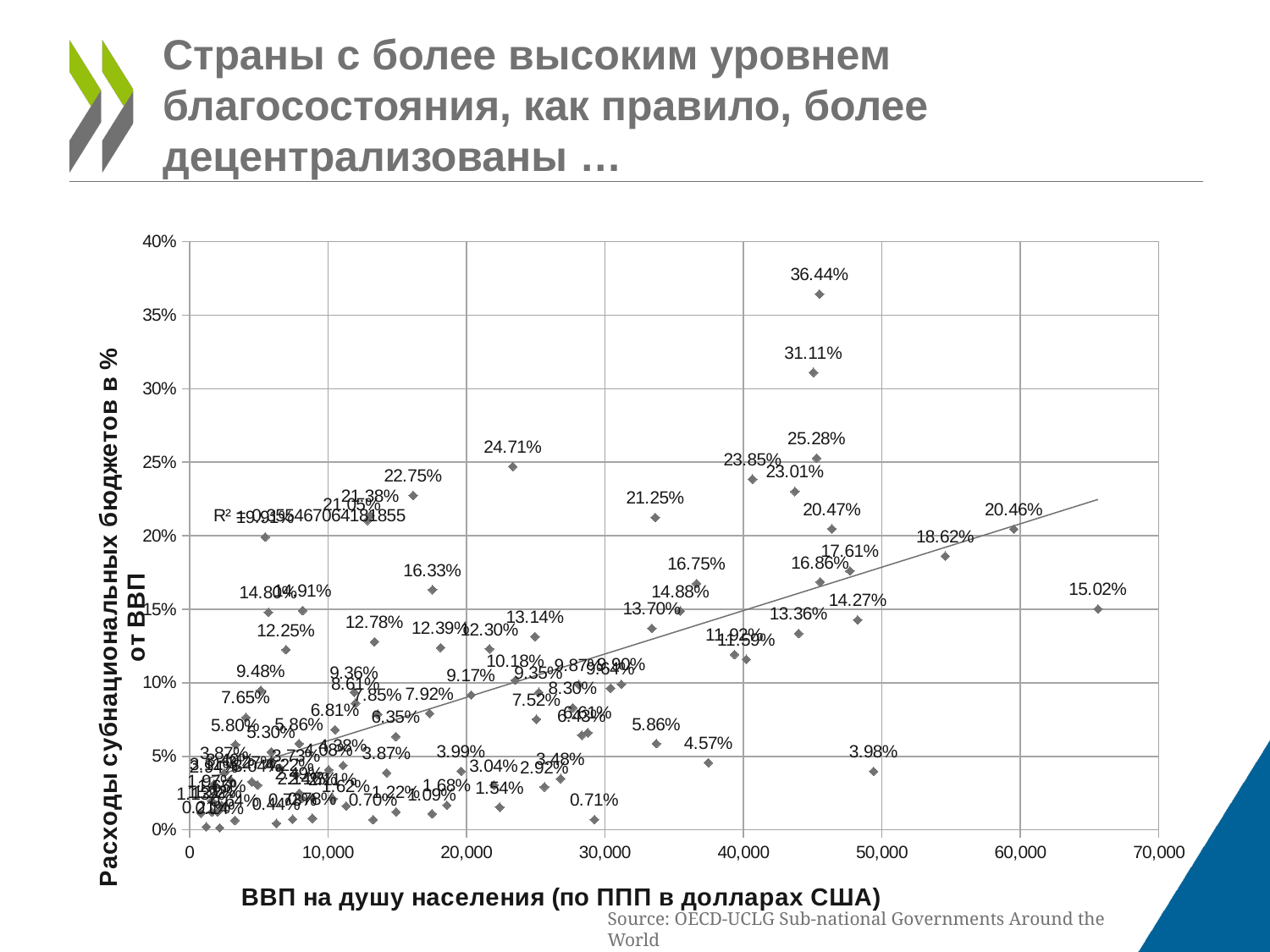
What is the second-highest data label value shown on the chart? 31.11% Which is larger: the point labelled 24.71% or the point labelled 22.75%? 24.71% Is the GDP per capita (x value) of the point labelled 36.44% greater or less than 40,000? greater What is the title of the x axis? ВВП на душу населения (по ППП в долларах США) Is the y value of the point labelled 24.71% greater or less than 20%? greater According to the trend line, do subnational budget expenditures generally rise or fall as GDP per capita increases? rise What is the highest data label value shown on the chart? 36.44% What is the data label of the rightmost point on the chart (near 65,000 on the x axis)? 15.02% What is the difference between the two highest labelled values on the chart (36.44% and 31.11%)? 5.33% What kind of chart is shown on the slide? scatter plot What is the maximum value shown on the y axis? 40%